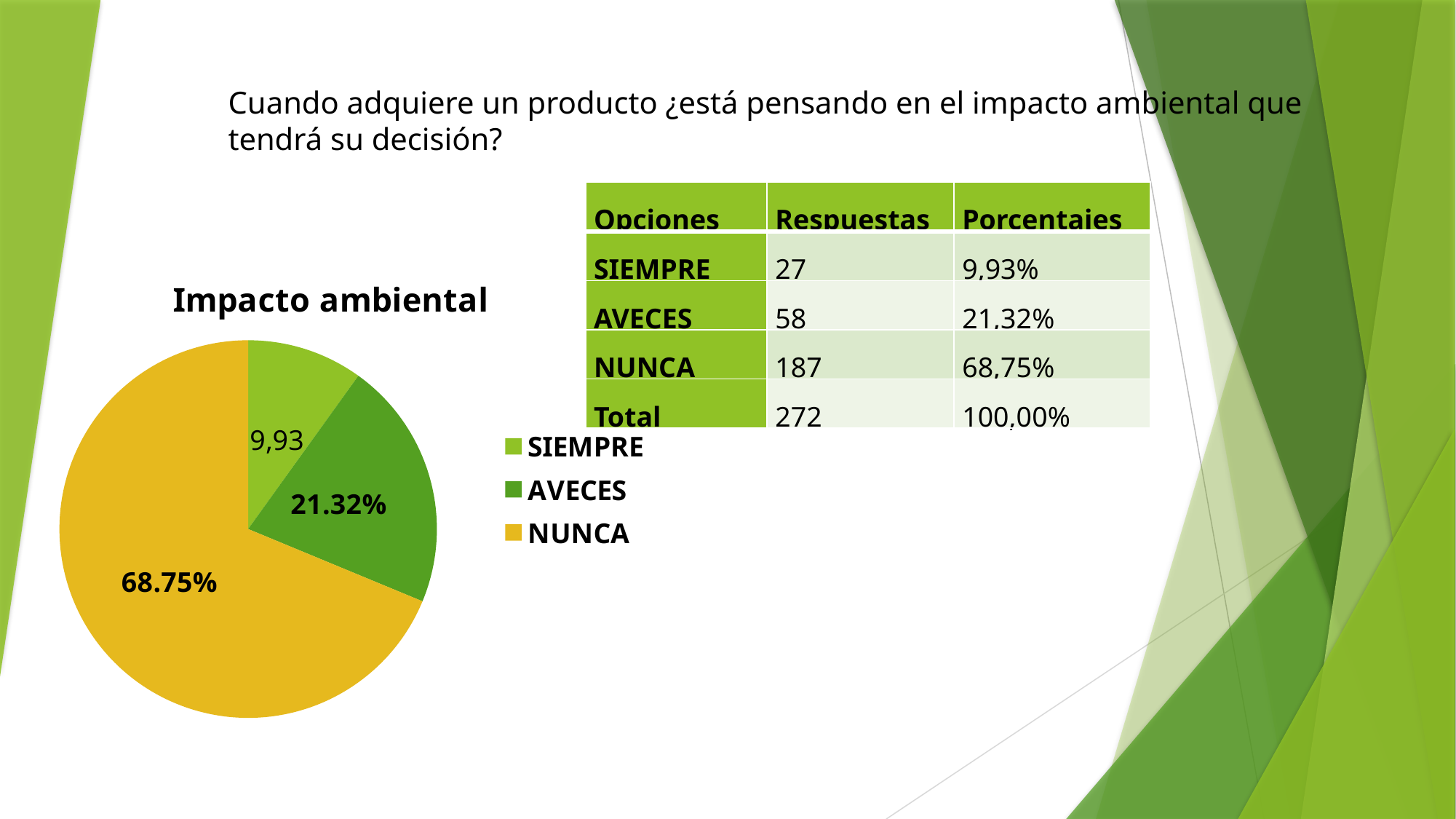
What is the difference in percentage points between the NUNCA slice and the AVECES slice? 47.43 How many slices does the pie chart have? 3 Which category has the largest slice of the pie chart? NUNCA Which slice is larger in the pie chart, AVECES or SIEMPRE? AVECES What value is labelled on the SIEMPRE slice of the pie chart? 9,93 What value is labelled on the NUNCA slice of the pie chart? 68.75% What kind of chart is shown on the slide? pie chart How many entries does the chart legend list? 3 What is the title of the chart? Impacto ambiental What value is labelled on the AVECES slice of the pie chart? 21.32% Which category has the smallest slice of the pie chart? SIEMPRE What colour is the NUNCA slice in the pie chart? yellow